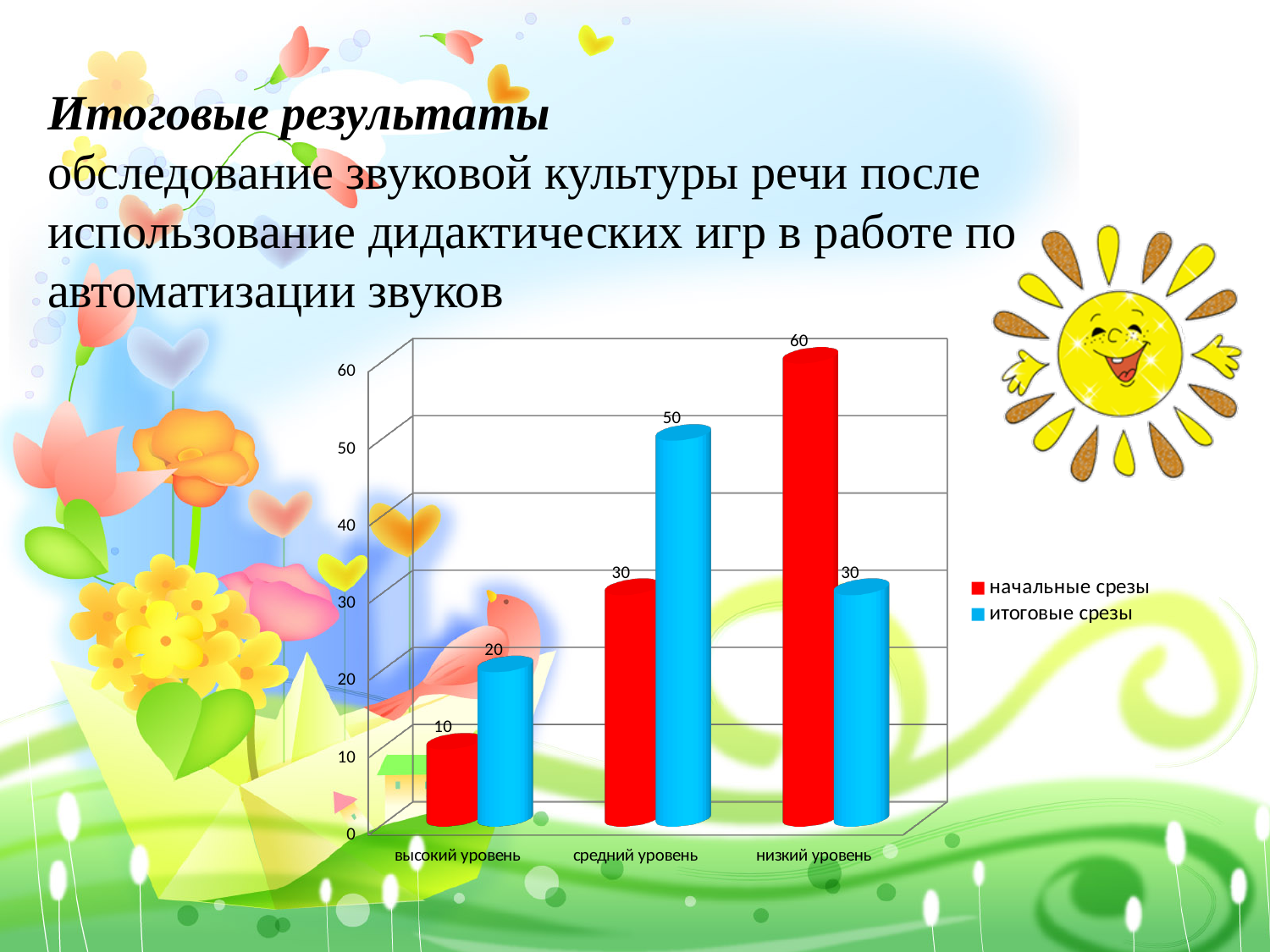
How many series does the legend list? 2 At 'средний уровень', which series has the larger value, 'начальные срезы' or 'итоговые срезы'? итоговые срезы Which category has the lowest value for 'итоговые срезы'? высокий уровень What is the value for 'начальные срезы' at 'низкий уровень'? 60 What is the difference between 'начальные срезы' and 'итоговые срезы' at 'низкий уровень'? 30 Which category has the highest value for 'начальные срезы'? низкий уровень What kind of chart is shown on the slide? bar chart How many categories are shown on the x axis? 3 What is the value for 'итоговые срезы' at 'средний уровень'? 50 What is the value for 'итоговые срезы' at 'высокий уровень'? 20 Which colour represents 'итоговые срезы' in the legend? blue What is the value for 'начальные срезы' at 'высокий уровень'? 10